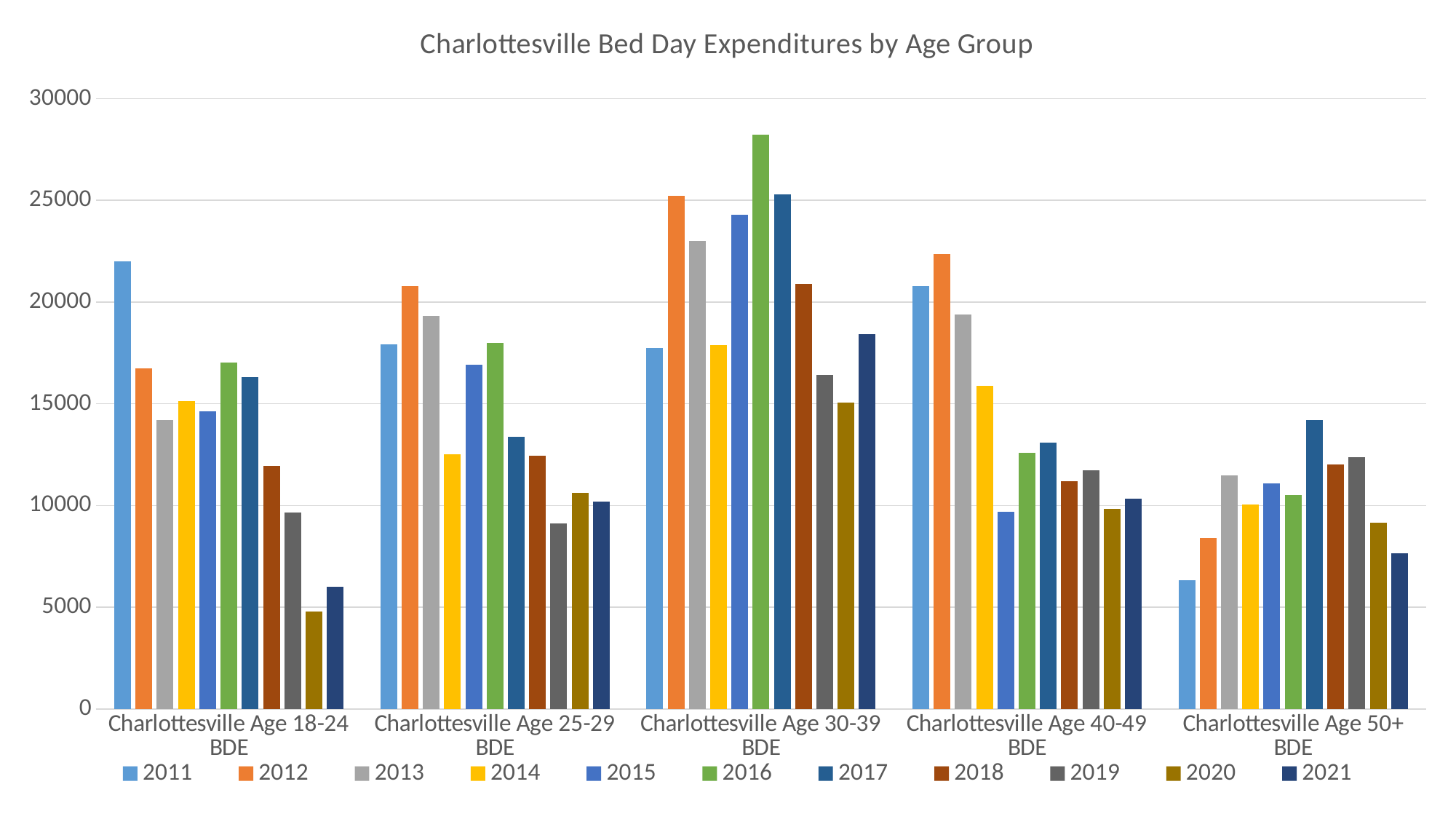
How many age-group categories are shown on the x axis? 5 For Charlottesville Age 18-24 BDE, which year has the lowest value? 2020 What kind of chart is shown on the slide? Bar chart What is the title of the chart? Charlottesville Bed Day Expenditures by Age Group Is the 2020 value for Charlottesville Age 18-24 BDE greater or less than 5000? less Is the 2011 value for Charlottesville Age 18-24 BDE greater or less than 20000? greater Is the 2016 value for Charlottesville Age 30-39 BDE greater or less than 25000? greater For Charlottesville Age 50+ BDE, which is larger: the 2011 value or the 2017 value? 2017 For Charlottesville Age 40-49 BDE, which is larger: the 2011 value or the 2012 value? 2012 For Charlottesville Age 50+ BDE, which year has the highest value? 2017 For Charlottesville Age 30-39 BDE, which year has the highest value? 2016 How many series (years) does the legend list? 11